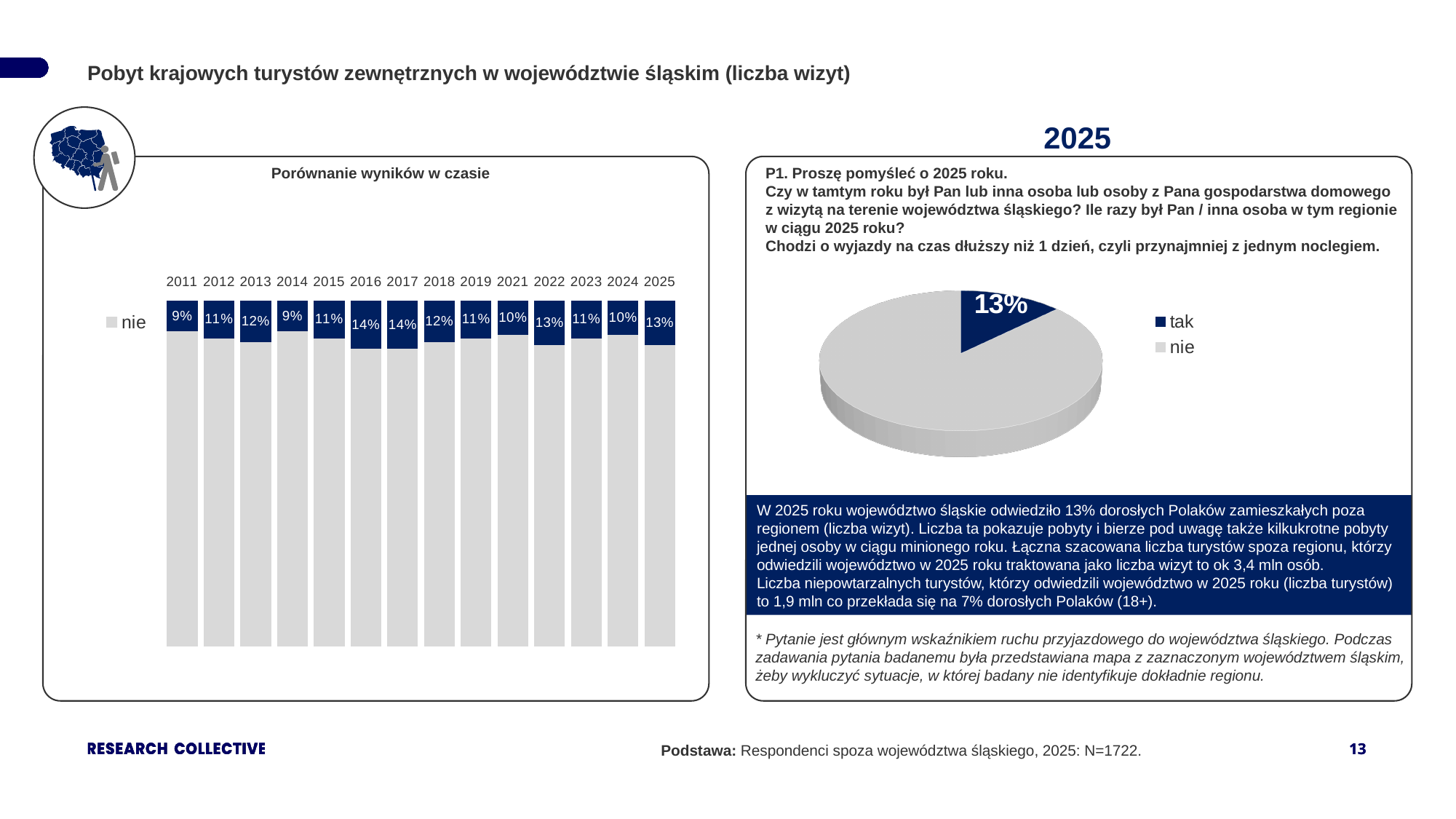
In the left chart 'Porównanie wyników w czasie', by how many percentage points does the dark blue value for 2025 exceed that for 2024? 3 percentage points In the pie chart on the right for 2025, what share is labelled for 'tak'? 13% In the left chart 'Porównanie wyników w czasie', which years have the lowest dark blue value? 2011 and 2014 What kind of chart is the left chart 'Porównanie wyników w czasie'? Stacked bar chart How many years are shown on the x axis of the left chart 'Porównanie wyników w czasie'? 14 What kind of chart is shown on the right side of the slide under '2025'? Pie chart How many entries does the legend of the pie chart on the right list? 2 In the left chart 'Porównanie wyników w czasie', which year has the larger dark blue value, 2022 or 2023? 2022 In the left chart 'Porównanie wyników w czasie', what is the highest dark blue value labelled on any bar? 14% In the left chart 'Porównanie wyników w czasie', what is the dark blue value shown for 2016? 14% In the left chart 'Porównanie wyników w czasie', what is the dark blue value shown for 2011? 9% In the left chart 'Porównanie wyników w czasie', what is the dark blue value shown for 2018? 12%